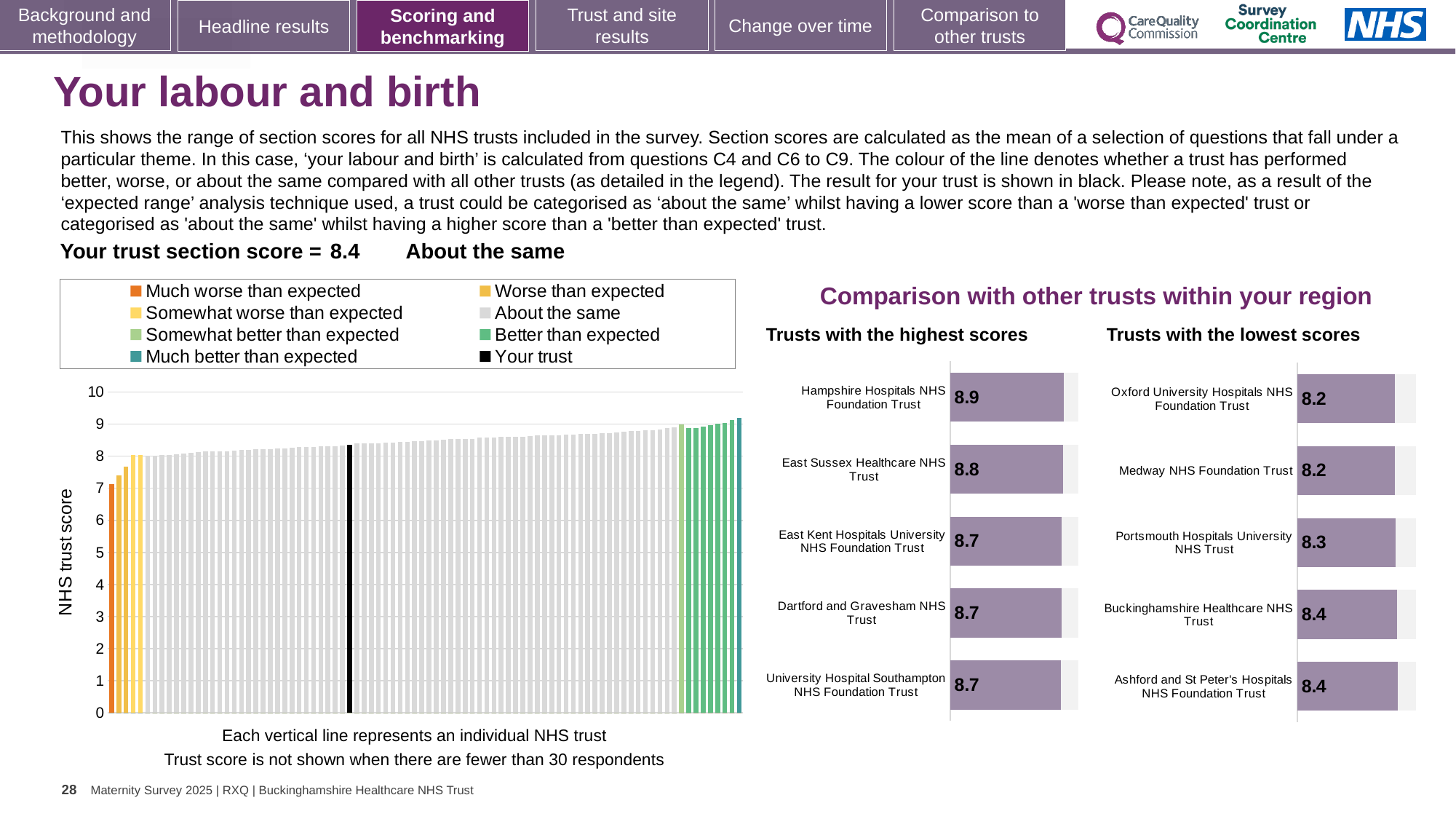
In the 'Trusts with the lowest scores' chart, what is the score for Medway NHS Foundation Trust? 8.2 In the 'Trusts with the lowest scores' chart, what is the difference between the scores of Buckinghamshire Healthcare NHS Trust and Oxford University Hospitals NHS Foundation Trust? 0.2 In the large chart on the left showing NHS trust scores, how many entries does the legend list? 8 In the 'Trusts with the lowest scores' chart, what is the score for Portsmouth Hospitals University NHS Trust? 8.3 In the large chart on the left, is the value of the lowest (orange) bar greater or less than 8? less In the 'Trusts with the highest scores' chart, which trust has the highest score? Hampshire Hospitals NHS Foundation Trust In the 'Trusts with the highest scores' chart, how many trusts are shown? 5 In the 'Trusts with the highest scores' chart, which has the larger score: Hampshire Hospitals NHS Foundation Trust or East Kent Hospitals University NHS Foundation Trust? Hampshire Hospitals NHS Foundation Trust What kind of chart is the large chart on the left showing NHS trust scores? Bar chart In the 'Trusts with the highest scores' chart, what is the score for Hampshire Hospitals NHS Foundation Trust? 8.9 In the 'Trusts with the highest scores' chart, what is the difference between the scores of Hampshire Hospitals NHS Foundation Trust and East Sussex Healthcare NHS Trust? 0.1 In the 'Trusts with the lowest scores' chart, which has the larger score: Portsmouth Hospitals University NHS Trust or Ashford and St Peter's Hospitals NHS Foundation Trust? Ashford and St Peter's Hospitals NHS Foundation Trust